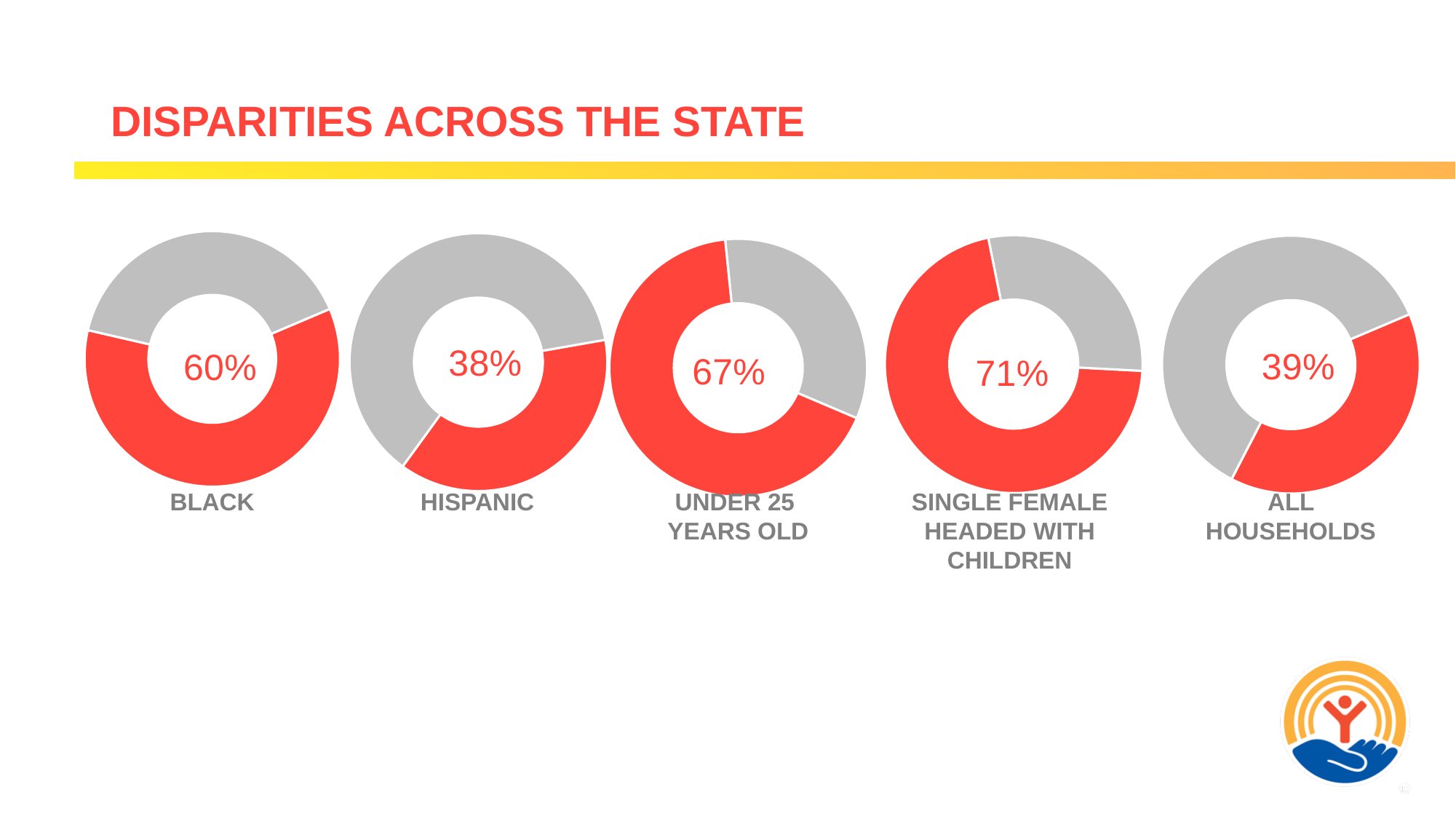
Which is larger: the percentage in the UNDER 25 YEARS OLD donut chart or the percentage in the BLACK donut chart? UNDER 25 YEARS OLD Which group's donut chart shows the highest percentage? SINGLE FEMALE HEADED WITH CHILDREN What percentage is shown in the ALL HOUSEHOLDS donut chart? 39% How many donut charts are shown on the slide? 5 What is the difference between the percentage in the BLACK donut chart and the percentage in the ALL HOUSEHOLDS donut chart? 21% What percentage is shown in the SINGLE FEMALE HEADED WITH CHILDREN donut chart? 71% What percentage is shown in the UNDER 25 YEARS OLD donut chart? 67% Which group's donut chart shows the lowest percentage? HISPANIC What type of chart is used for each group on the slide? Donut (pie) chart What percentage is shown in the BLACK donut chart? 60% What percentage is shown in the HISPANIC donut chart? 38% What is the title of the slide containing the donut charts? DISPARITIES ACROSS THE STATE